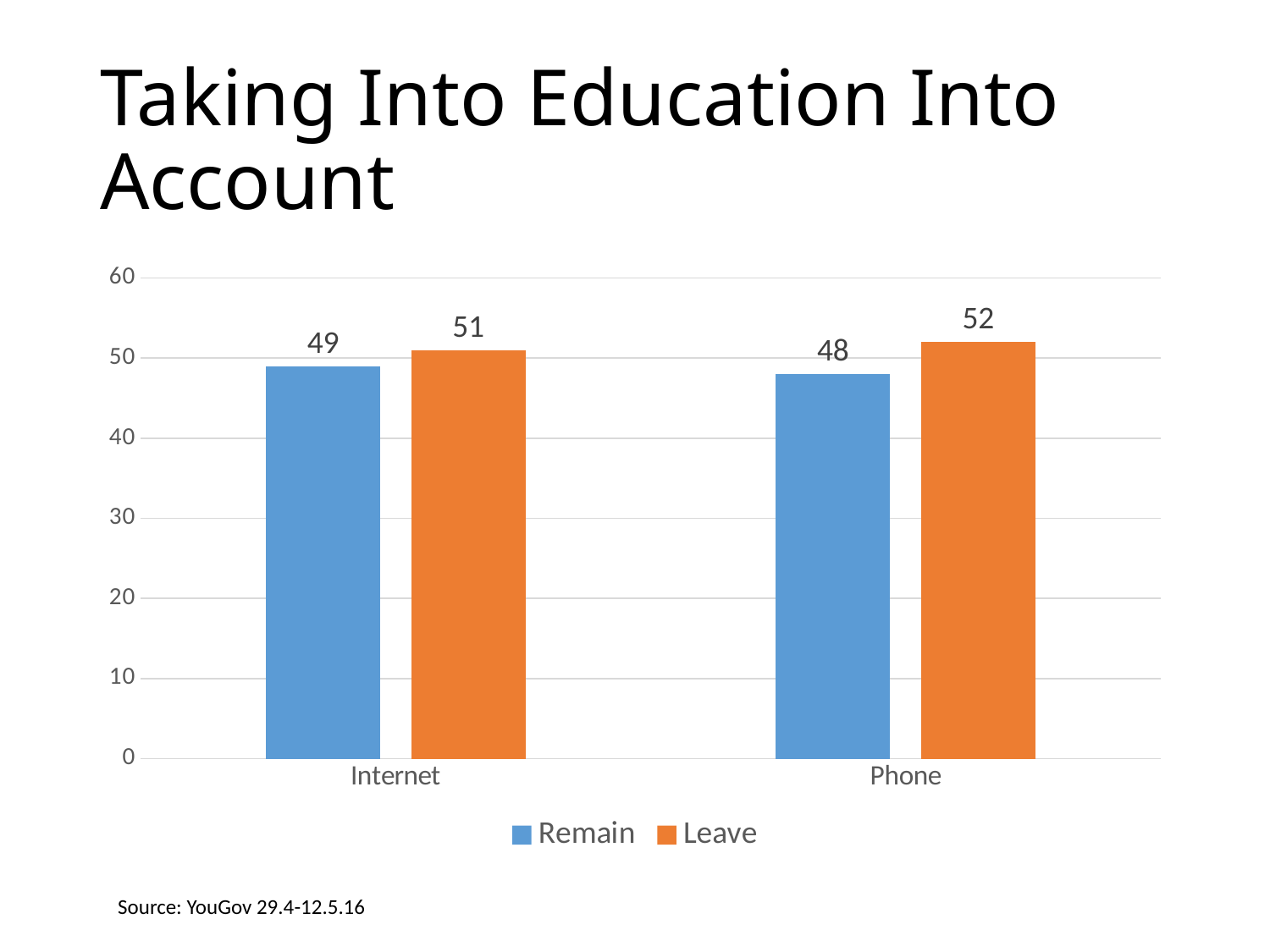
What is the Remain value for Internet? 49 How many series does the legend list? 2 Which is larger for Internet, Remain or Leave? Leave What is the Leave value for Internet? 51 What is the difference between the Leave and Remain values for Internet? 2 How many categories are shown on the x axis? 2 What is the Remain value for Phone? 48 What is the Leave value for Phone? 52 Which category has the highest Leave value? Phone What kind of chart is shown on the slide? Bar chart What is the difference between the Leave and Remain values for Phone? 4 Which category has the lowest Remain value? Phone